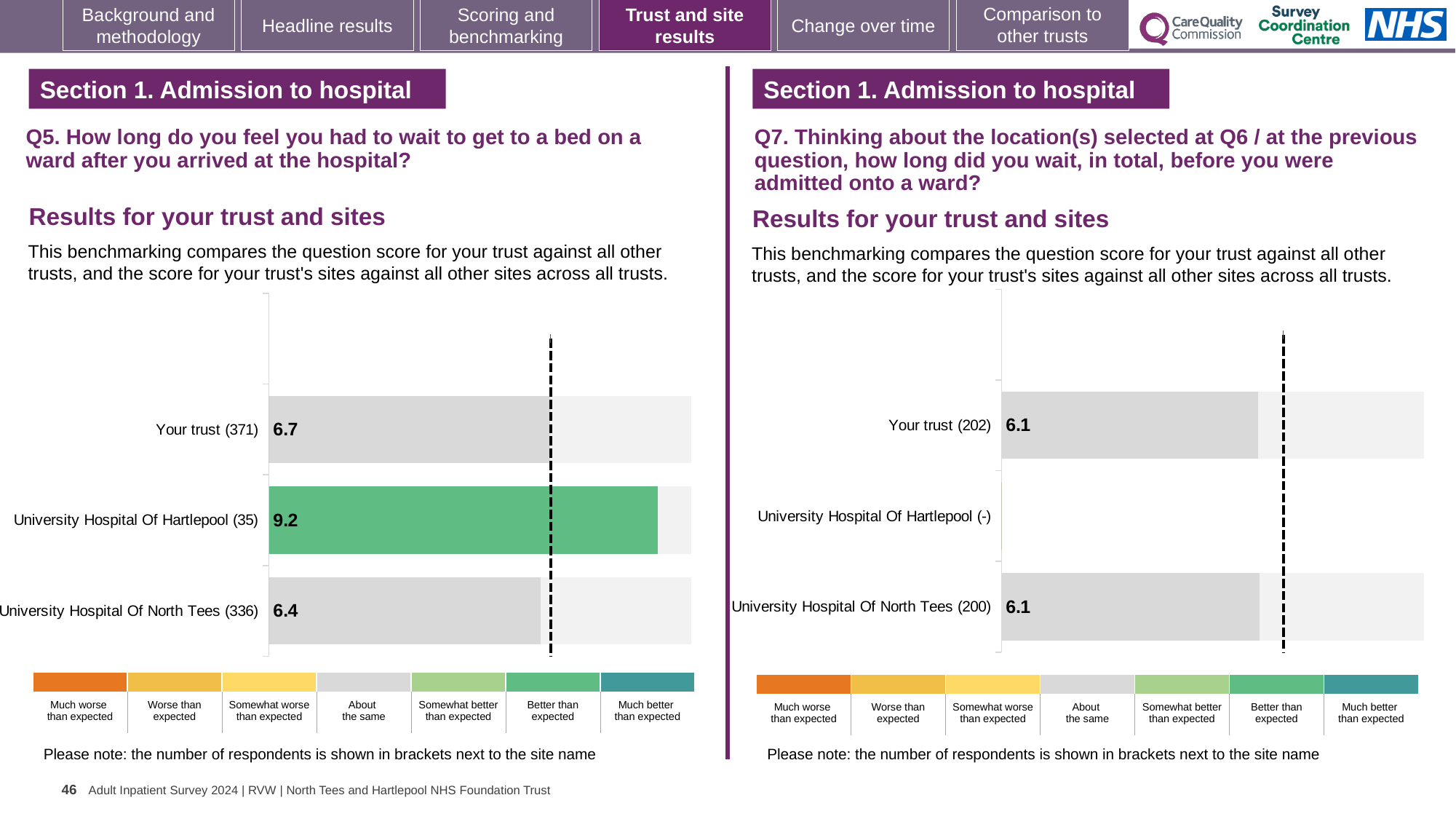
On the Q5 chart (left), what is the score for University Hospital Of Hartlepool? 9.2 On the Q5 chart (left), what is the difference between the scores for University Hospital Of Hartlepool and University Hospital Of North Tees? 2.8 On the Q7 chart (right), how many respondents are shown for Your trust? 202 What kind of chart is used on the Q5 chart (left)? Bar chart On the Q5 chart (left), what is the score for Your trust? 6.7 On the Q7 chart (right), what is the score for University Hospital Of North Tees? 6.1 On the Q5 chart (left), which has the larger score: Your trust or University Hospital Of North Tees? Your trust How many bars (rows) are plotted on the Q5 chart (left)? 3 On the Q7 chart (right), what is the score for Your trust? 6.1 On the Q5 chart (left), what is the score for University Hospital Of North Tees? 6.4 On the Q5 chart (left), which site or trust has the highest score? University Hospital Of Hartlepool On the Q5 chart (left), which site or trust has the lowest score? University Hospital Of North Tees